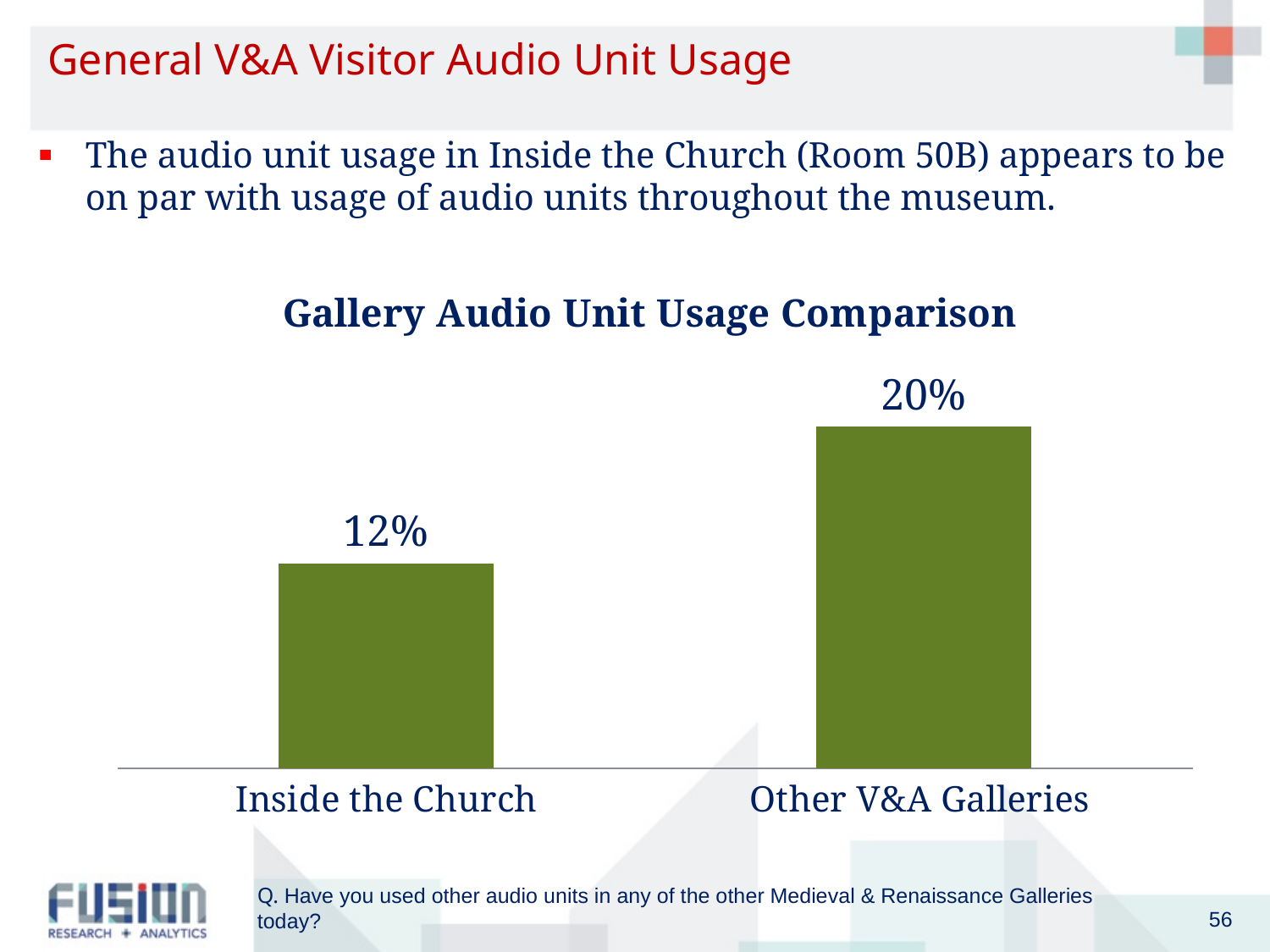
How many categories are shown in the chart? 2 What is the difference in audio unit usage between Other V&A Galleries and Inside the Church? 8% What is the audio unit usage value for Inside the Church? 12% What is the audio unit usage value for Other V&A Galleries? 20% What is the title of the chart? Gallery Audio Unit Usage Comparison What colour are the bars in the chart? Green Which category has the lowest audio unit usage? Inside the Church What kind of chart is shown on the slide? Bar chart Which is larger, the value for Inside the Church or the value for Other V&A Galleries? Other V&A Galleries Which category has the highest audio unit usage? Other V&A Galleries